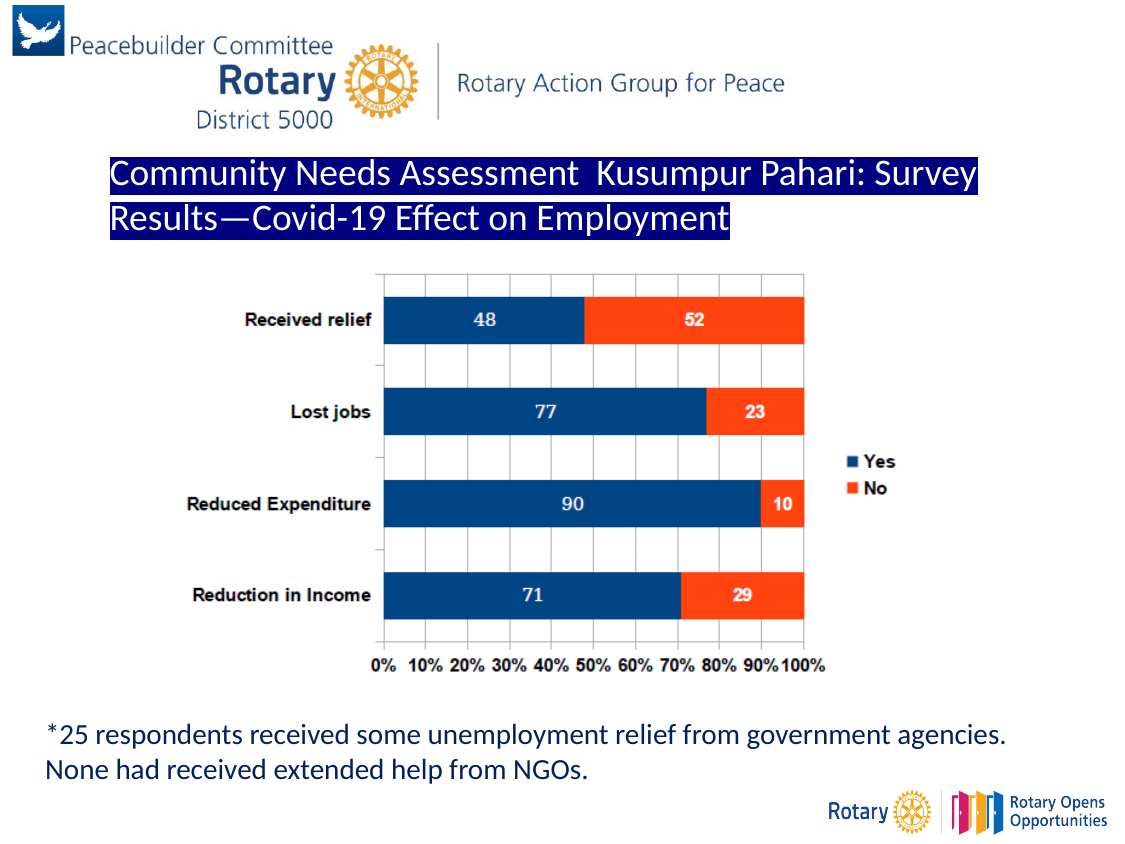
What is the 'Yes' value for Lost jobs? 77 What is the 'Yes' value for Reduction in Income? 71 Which category has the lowest 'Yes' value? Received relief What is the total of the stacked bar for Lost jobs? 100 What is the difference between the 'Yes' and 'No' values for Reduced Expenditure? 80 Which category has the highest 'Yes' value? Reduced Expenditure Which colour represents the 'No' series in the legend? Orange What kind of chart is shown on the slide? Stacked bar chart How many series does the legend list? 2 What is the 'No' value for Received relief? 52 How many categories are shown on the chart? 4 Which is larger, the 'No' value for Lost jobs or the 'No' value for Reduction in Income? Reduction in Income